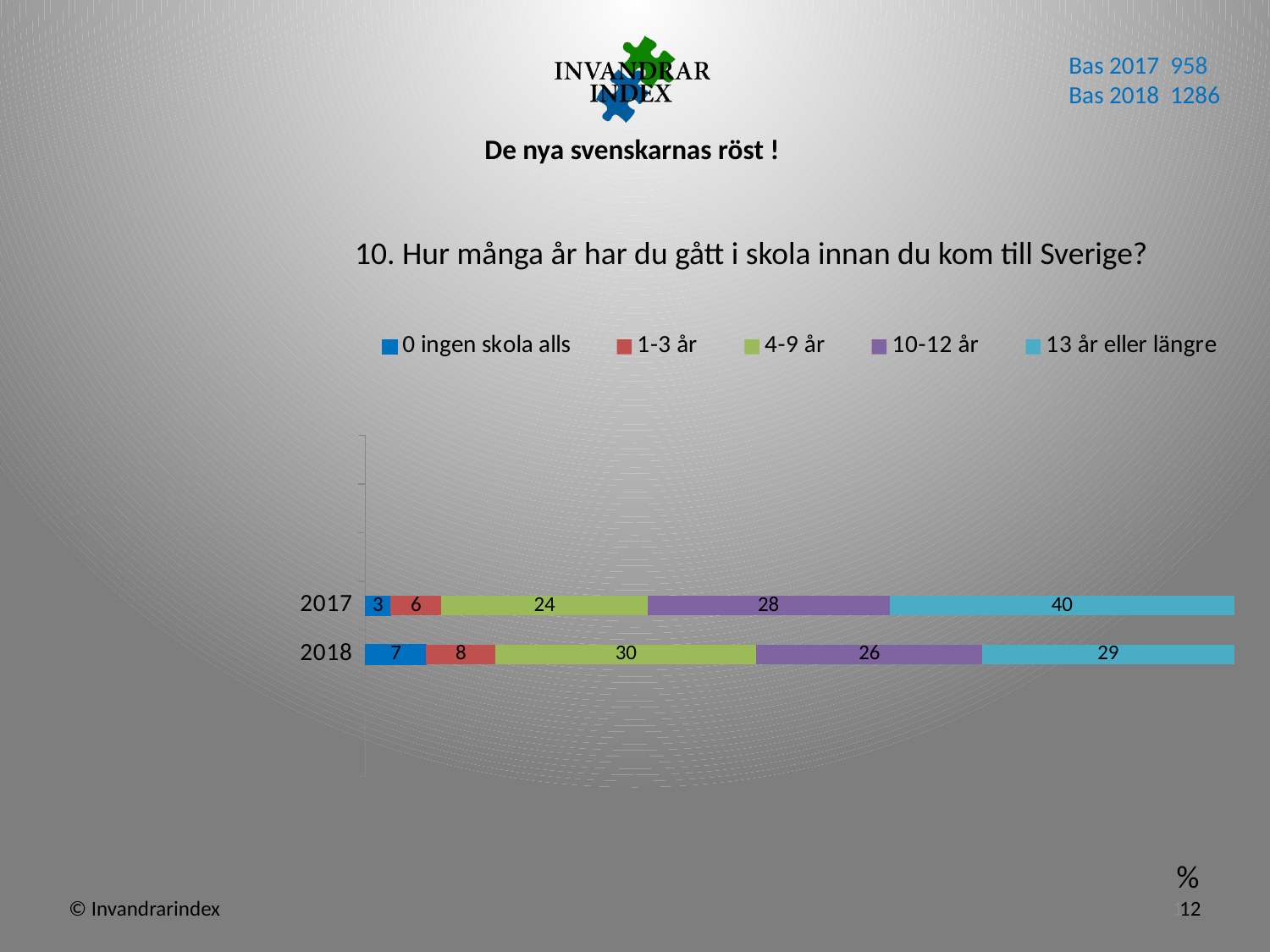
What is the difference between the '13 år eller längre' values for 2017 and 2018? 11 What is the value for '0 ingen skola alls' in 2017? 3 Which year has the larger value for '1-3 år', 2017 or 2018? 2018 How many series does the legend list? 5 Which series has the highest value in the 2017 bar? 13 år eller längre What is the value for '10-12 år' in 2018? 26 What kind of chart is shown on the slide? stacked bar chart How many years (categories) are plotted in the chart? 2 What is the total of the 2018 stacked bar? 100 Which series has the lowest value in the 2018 bar? 0 ingen skola alls What is the value for '4-9 år' in 2018? 30 What is the value for '13 år eller längre' in 2017? 40